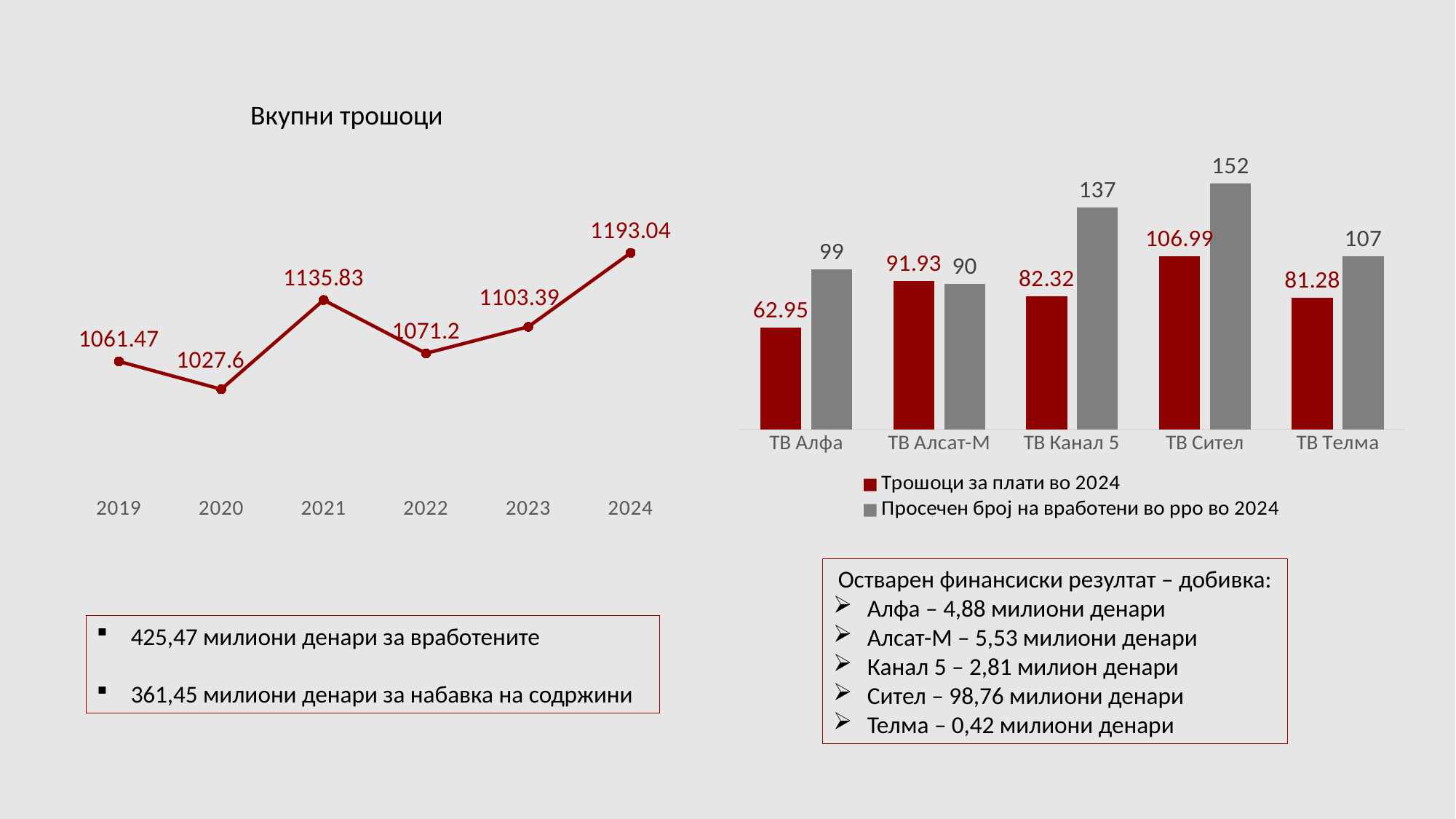
In the 'Вкупни трошоци' chart, which year has the lowest value? 2020 In the 'Вкупни трошоци' chart, what is the value for 2021? 1135.83 In the 'Вкупни трошоци' chart, how many years are plotted on the x axis? 6 In the 'Вкупни трошоци' chart, what is the difference between the 2024 value and the 2023 value? 89.65 In the 'Вкупни трошоци' chart, which year has the highest value? 2024 What kind of chart is the 'Вкупни трошоци' chart on the left? Line chart In the bar chart on the right, how many series does the legend list? 2 In the bar chart on the right, what is the value of 'Трошоци за плати во 2024' for ТВ Сител? 106.99 In the bar chart on the right, which TV station has the highest 'Просечен број на вработени во ppo во 2024'? ТВ Сител In the bar chart on the right, which TV station has the lowest 'Трошоци за плати во 2024'? ТВ Алфа In the bar chart on the right, what is the value of 'Просечен број на вработени во ppo во 2024' for ТВ Канал 5? 137 In the bar chart on the right, which is larger: 'Трошоци за плати во 2024' for ТВ Алсат-М or for ТВ Телма? ТВ Алсат-М